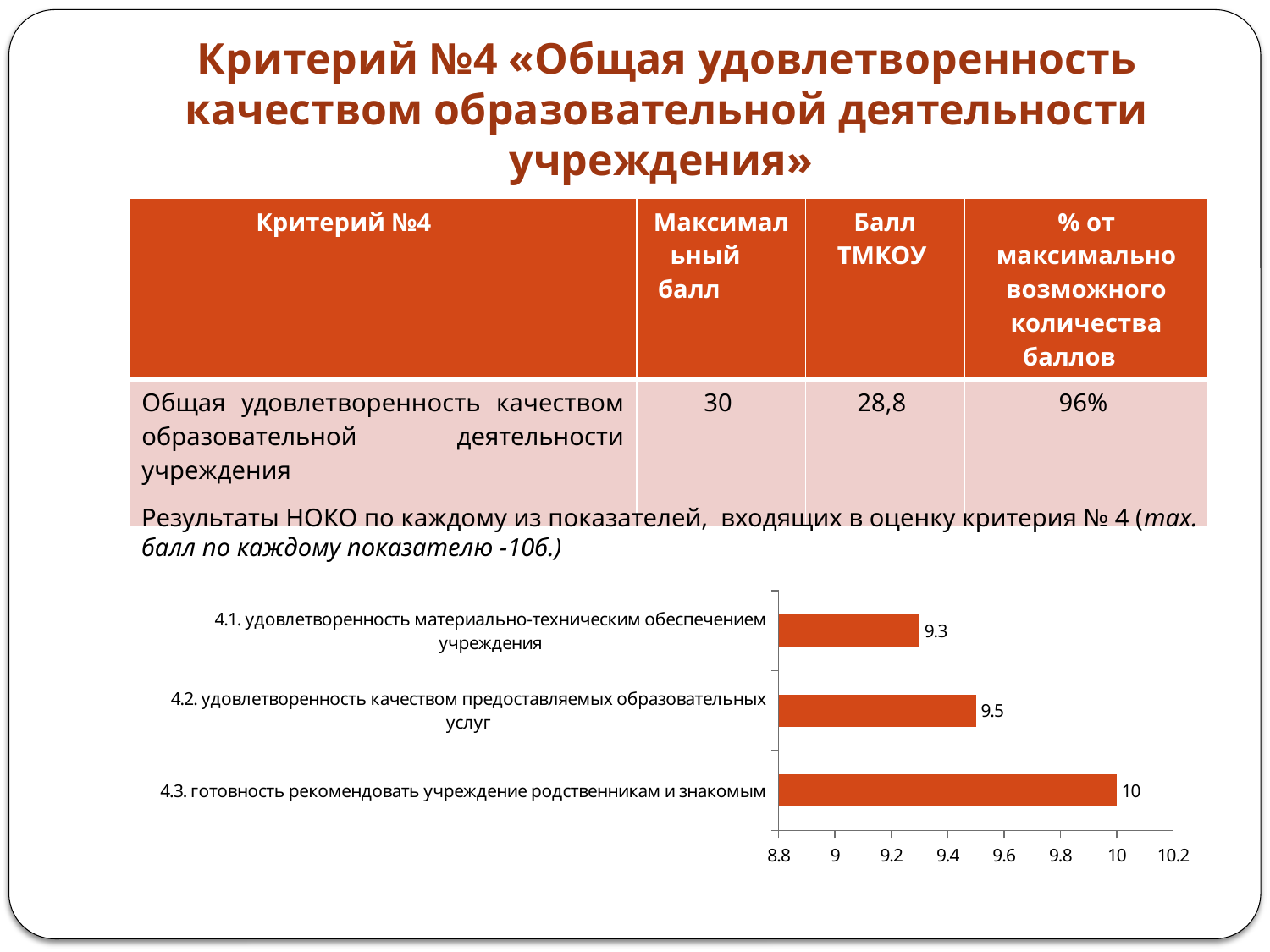
Which category has the highest value? 4.3. готовность рекомендовать учреждение родственникам и знакомым What is the value for 4.1. удовлетворенность материально-техническим обеспечением учреждения? 9.3 What is the value for 4.3. готовность рекомендовать учреждение родственникам и знакомым? 10 How many categories are shown in the chart? 3 What is the maximum value shown on the horizontal axis of the chart? 10.2 Is the value for 4.1 greater or less than 9.4? less What is the difference between the values for 4.2 and 4.1? 0.2 Which category has the lowest value? 4.1. удовлетворенность материально-техническим обеспечением учреждения What is the difference between the values for 4.3 and 4.1? 0.7 What is the value for 4.2. удовлетворенность качеством предоставляемых образовательных услуг? 9.5 Which is larger, the value for 4.2 or the value for 4.1? 4.2 What kind of chart is shown on the slide? bar chart